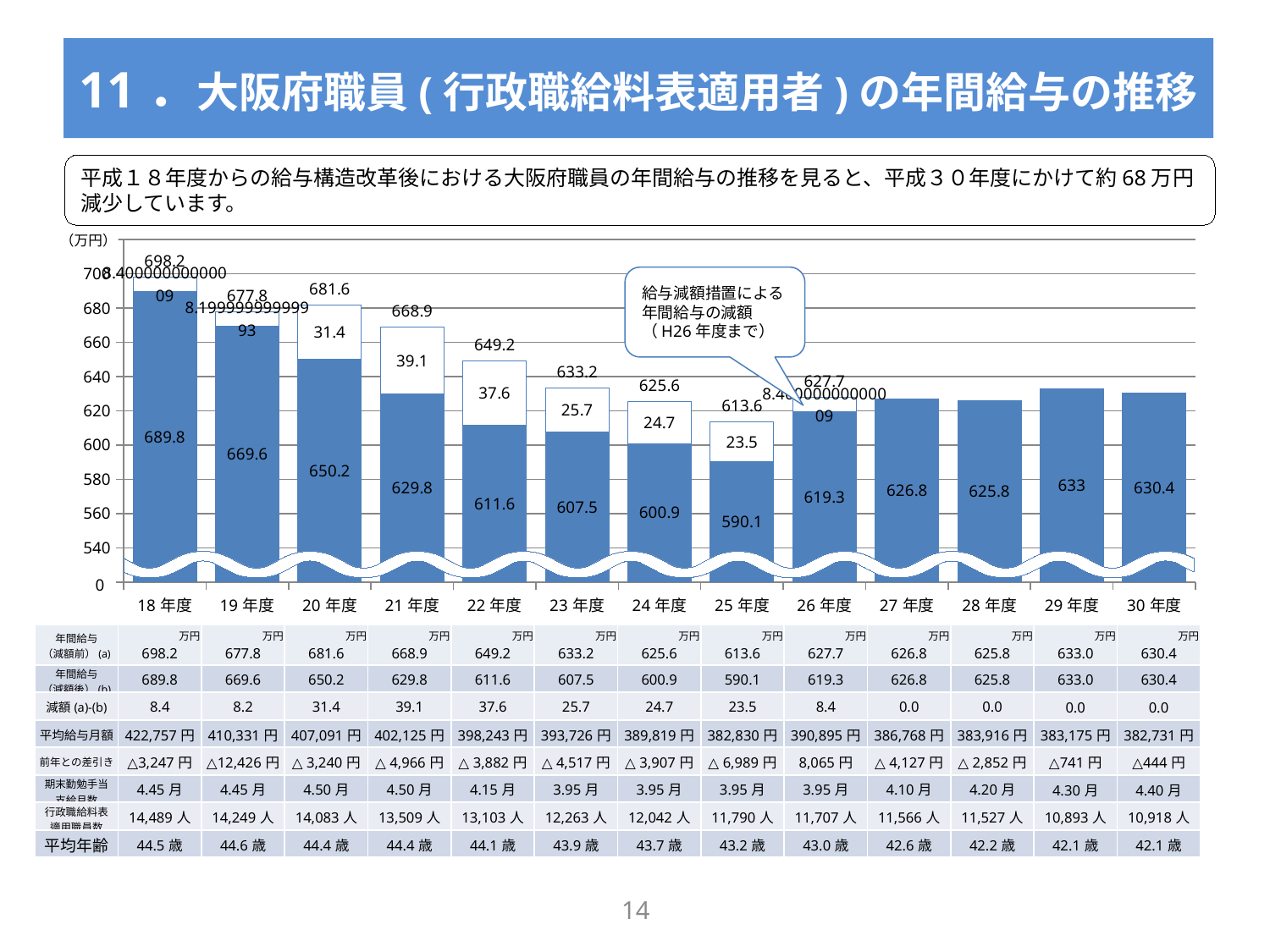
Which is larger, the blue bar for 21年度 or the blue bar for 22年度? 21年度 What is the value of the blue (減額後) bar for 20年度? 650.2 What is the value of the blue (減額後) bar for 25年度? 590.1 Which year has the highest total (減額前) annual salary shown above the bars? 18年度 Do the blue bar values rise or fall from 18年度 to 25年度? fall Which year has the lowest blue (減額後) bar? 25年度 Is the value of the 27年度 bar greater or less than 620? greater What is the value of the white (減額) segment stacked on the 22年度 bar? 37.6 What kind of chart is used to show the annual salary trend? bar chart How many fiscal years are shown on the x axis of the chart? 13 What is the total of the stacked bar for 21年度 (629.8 + 39.1)? 668.9 What is the difference between the blue bar values for 18年度 (689.8) and 30年度 (630.4)? 59.4